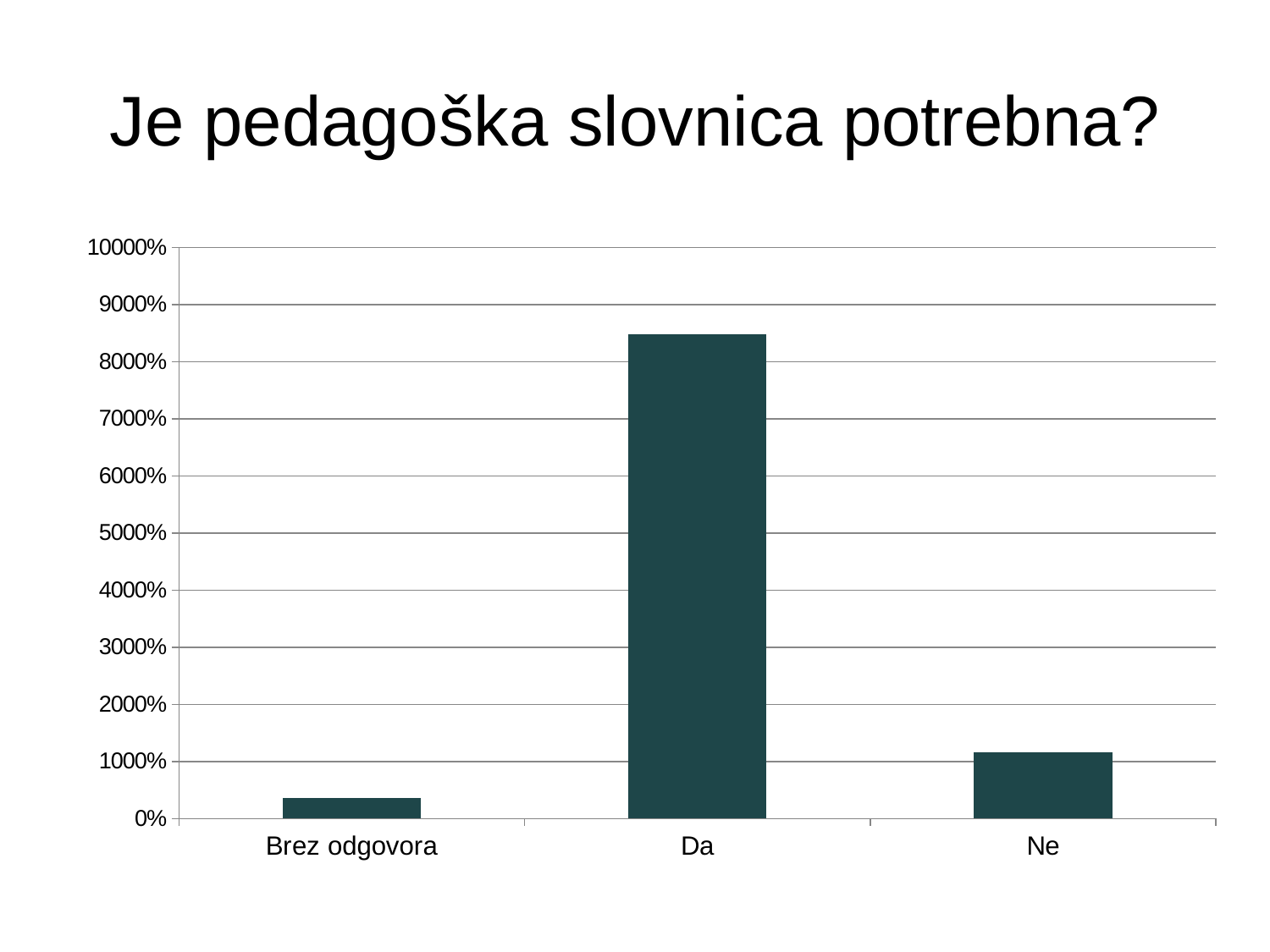
How many categories are shown on the x axis of the chart? 3 Which category has the lowest bar? Brez odgovora What kind of chart is shown on the slide? bar chart What is the highest value shown on the vertical axis of the chart? 10000% Which is larger, the value for Da or the value for Ne? Da Which category has the highest bar? Da Is the value for Da greater or less than 8000%? greater What is the title of the slide containing the chart? Je pedagoška slovnica potrebna? Is the value for Da greater or less than 9000%? less Is the value for Ne greater or less than 2000%? less Which is larger, the value for Ne or the value for Brez odgovora? Ne